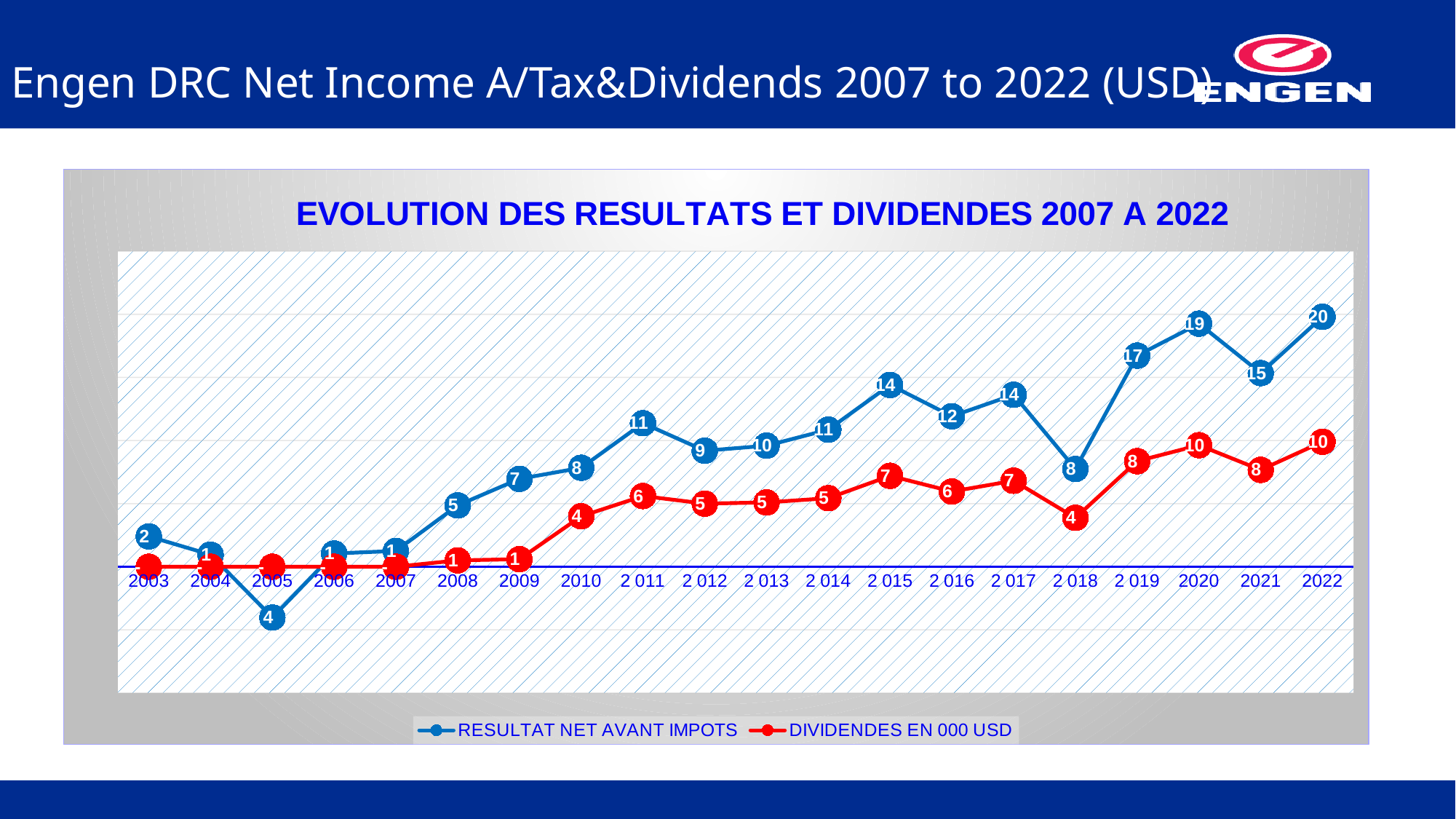
By how much did RESULTAT NET AVANT IMPOTS increase from 2018 to 2020? 11 What is the value of RESULTAT NET AVANT IMPOTS in 2018? 8 How many series does the legend list? 2 Between 2008 and 2022, in which year is RESULTAT NET AVANT IMPOTS lowest? 2008 What kind of chart is shown on the slide? Line chart Does RESULTAT NET AVANT IMPOTS rise or fall from 2018 to 2020? Rise How many years are shown on the x axis of the chart? 20 In which year is RESULTAT NET AVANT IMPOTS highest? 2022 What is the difference between RESULTAT NET AVANT IMPOTS and DIVIDENDES EN 000 USD in 2022? 10 What is the value of RESULTAT NET AVANT IMPOTS in 2022? 20 What is the value of DIVIDENDES EN 000 USD in 2020? 10 Which year has the higher RESULTAT NET AVANT IMPOTS, 2019 or 2021? 2019